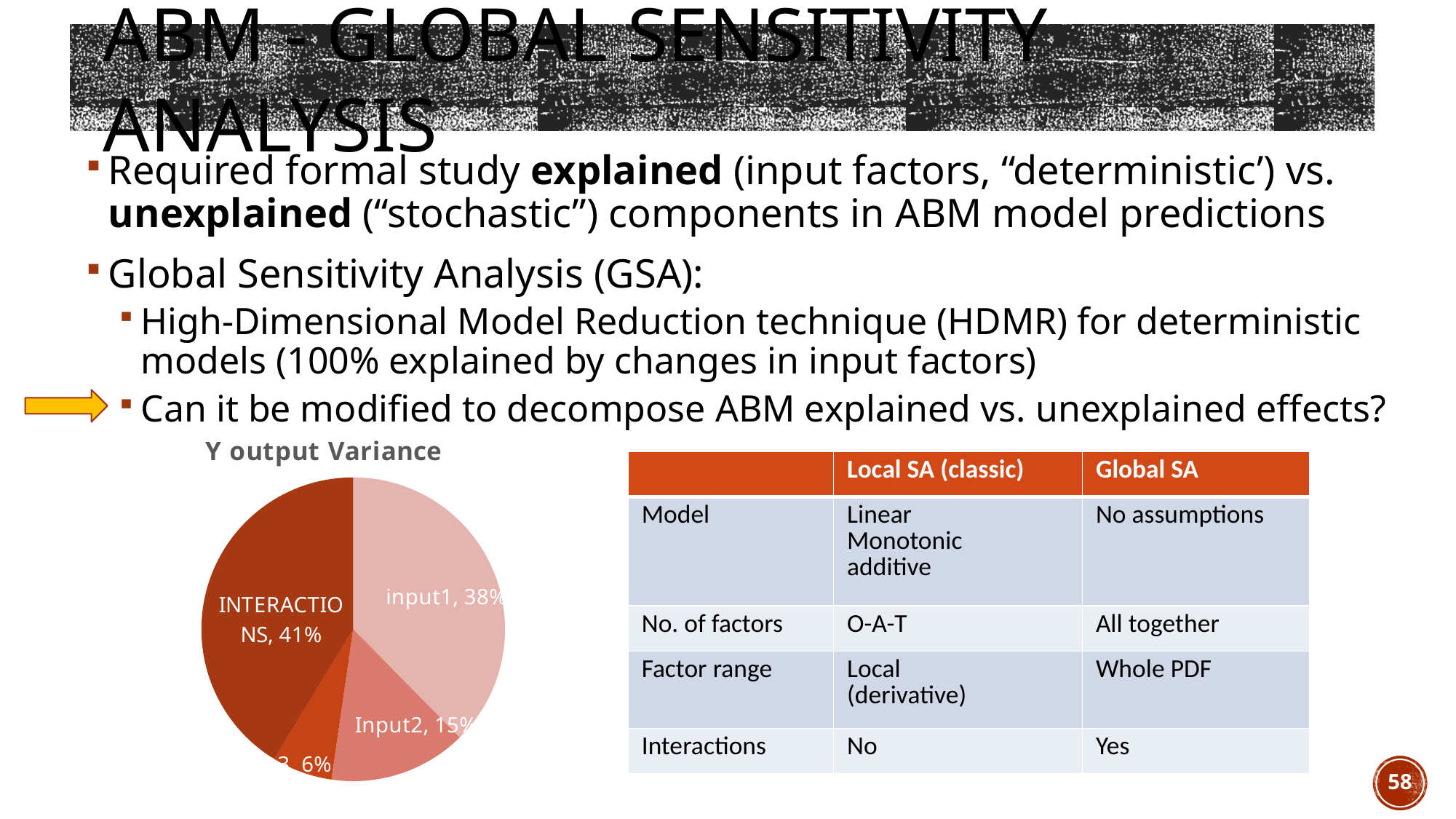
What is the combined share of the input1 and Input2 slices? 53% What is the difference in percentage points between the INTERACTIONS slice and the input1 slice? 3 What is the title of the pie chart? Y output Variance Which is larger, the INTERACTIONS slice or the input1 slice? INTERACTIONS Which slice of the pie chart is the largest? INTERACTIONS What share of the pie does input1 account for? 38% What share of the pie does INTERACTIONS account for? 41% What share of the pie does Input2 account for? 15% What kind of chart is shown on the slide? pie chart How many slices does the pie chart have? 4 What is the difference in percentage points between the input1 slice and the Input2 slice? 23 Which is larger, the input1 slice or the Input2 slice? input1